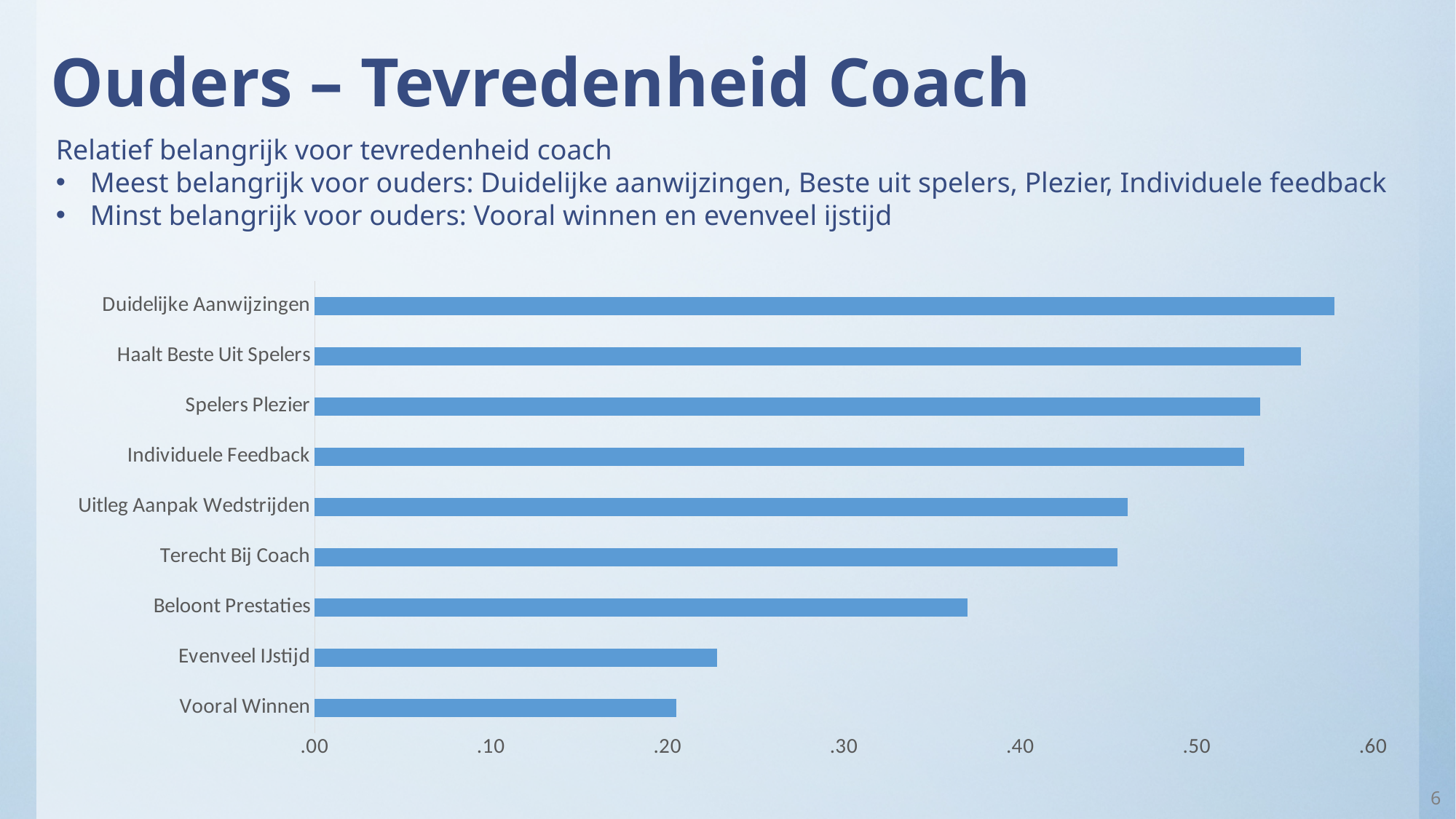
Which is larger, the value for Individuele Feedback or the value for Uitleg Aanpak Wedstrijden? Individuele Feedback Which is larger, the value for Beloont Prestaties or the value for Evenveel IJstijd? Beloont Prestaties Is the value for Vooral Winnen greater or less than .30? less Is the value for Duidelijke Aanwijzingen greater or less than .50? greater Which category has the lowest value in the chart? Vooral Winnen Which category has the highest value in the chart? Duidelijke Aanwijzingen Is the value for Beloont Prestaties greater or less than .40? less What kind of chart is shown on the slide? bar chart What is the highest value shown on the horizontal axis of the chart? .60 How many categories are plotted in the chart? 9